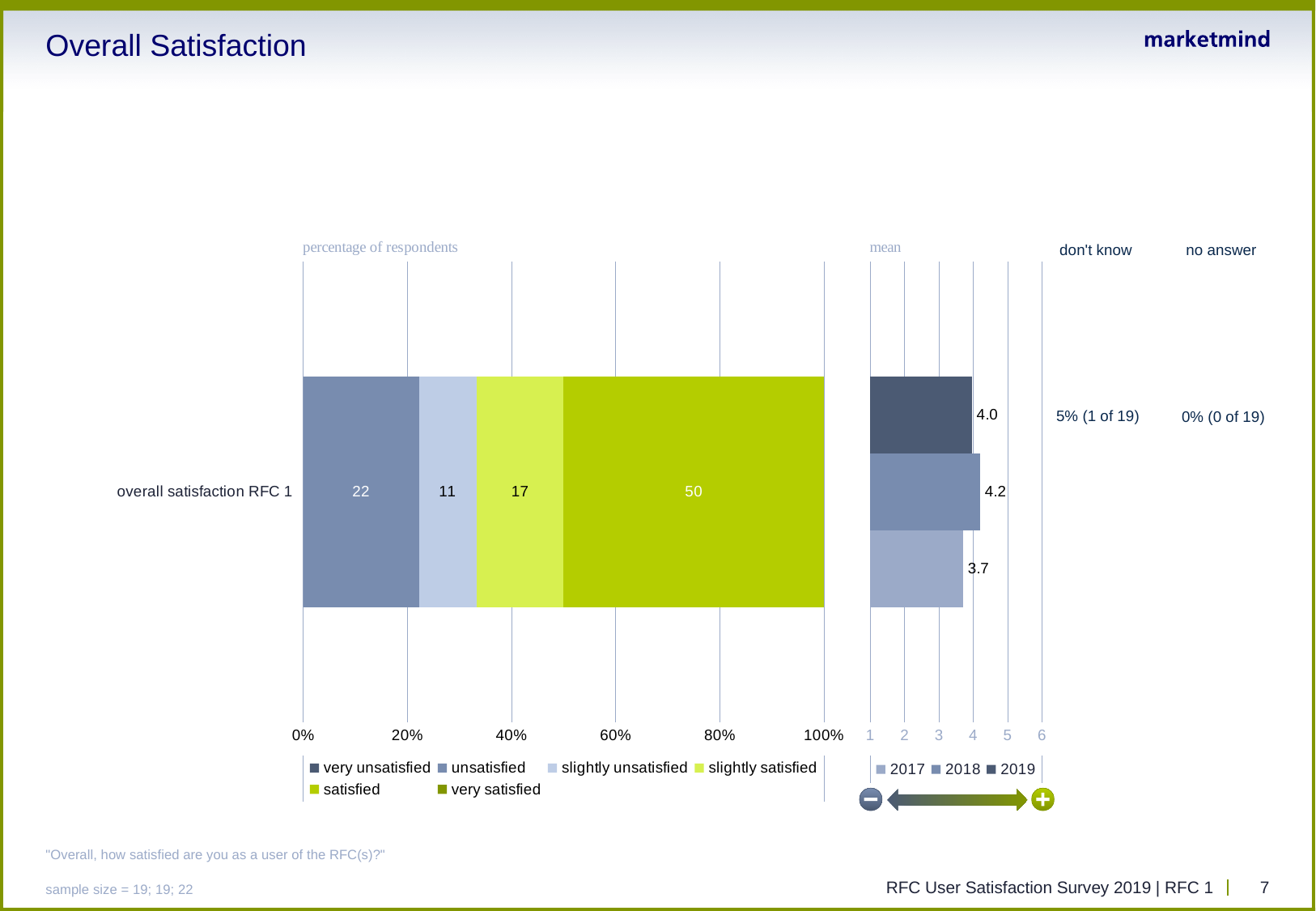
In the mean chart, what is the mean value for 2017? 3.7 In the percentage of respondents chart, what is the value of the smallest segment of the overall satisfaction RFC 1 bar? 11 In the mean chart, what is the difference between the 2018 mean and the 2017 mean? 0.5 In the mean chart, what is the mean value for 2018? 4.2 What kind of chart is the percentage of respondents chart? Stacked bar chart In the percentage of respondents chart, what is the value of the unsatisfied segment for overall satisfaction RFC 1? 22 In the percentage of respondents chart, how many series does the legend list? 6 In the mean chart, what is the mean value for 2019? 4.0 In the percentage of respondents chart, what is the value of the slightly satisfied segment for overall satisfaction RFC 1? 17 In the mean chart, which year has the lowest mean? 2017 In the percentage of respondents chart, what is the difference between the largest segment (50) and the unsatisfied segment (22)? 28 In the percentage of respondents chart, what is the value of the largest segment of the overall satisfaction RFC 1 bar? 50